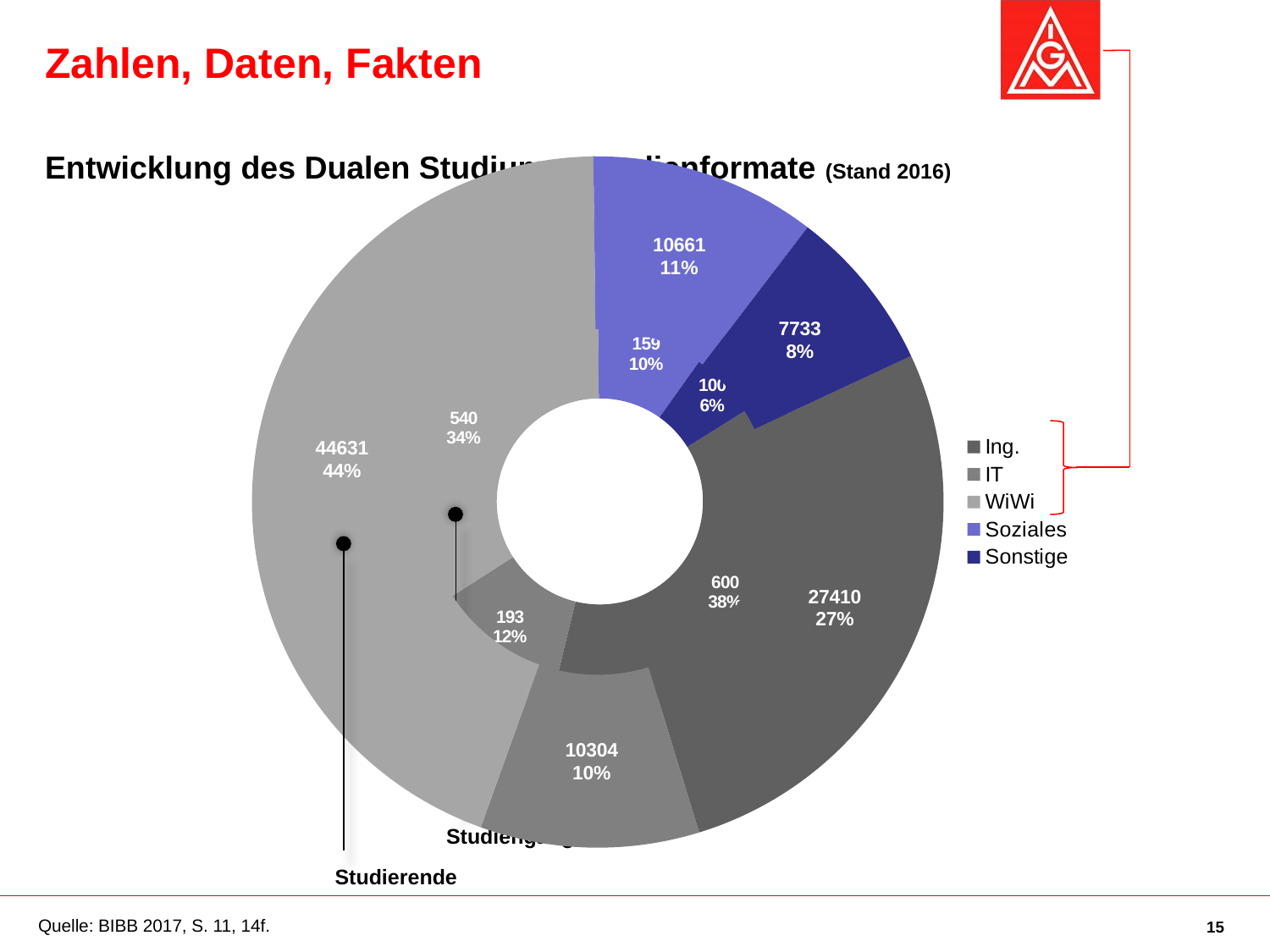
How many categories does the legend of the chart list? 5 In the outer ring (Studierende), what is the difference between the WiWi value and the Ing. value? 17221 In the inner ring (Studiengänge), what percentage share is shown for Ing.? 38% What is the total of the five Studierende values in the outer ring? 100739 Which category has the smallest share of Studierende in the outer ring? Sonstige In the outer ring (Studierende), what percentage share is shown for Ing.? 27% In the inner ring (Studiengänge), what value is shown for IT? 193 What kind of chart is shown on the slide? Doughnut chart In the outer ring (Studierende), which is larger: the value for Soziales or the value for IT? Soziales Which category has the largest share of Studiengänge in the inner ring? Ing. In the outer ring (Studierende), what is the number of students for WiWi? 44631 Which category has the largest share of Studierende in the outer ring? WiWi